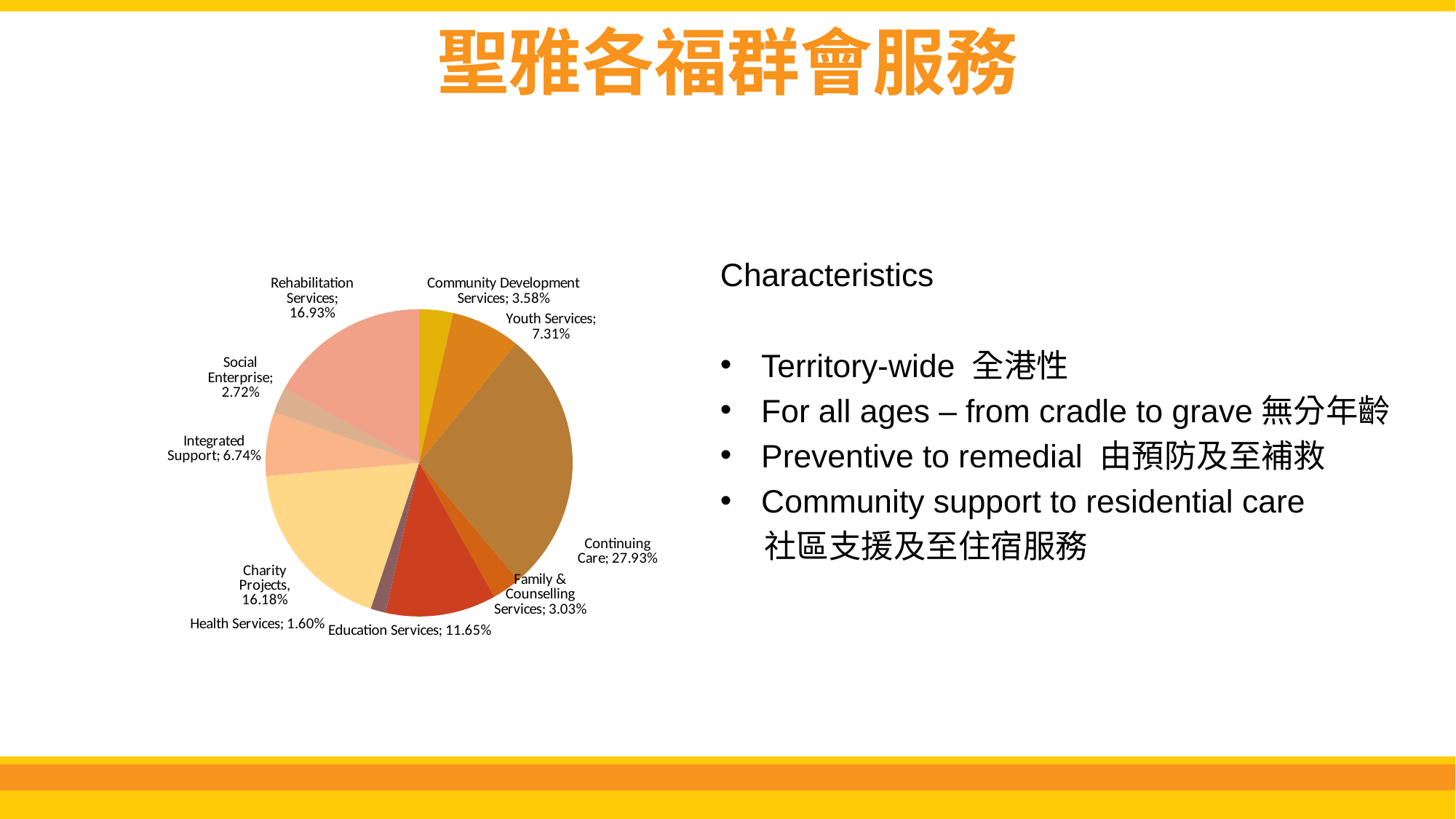
Which category has the largest slice of the pie? Continuing Care What is the difference between Continuing Care and Charity Projects? 11.75% What share of the pie does Continuing Care have? 27.93% How many slices does the pie chart have? 10 Which is larger, Youth Services or Integrated Support? Youth Services What is the difference between Rehabilitation Services and Charity Projects? 0.75% Which category has the smallest slice of the pie? Health Services What is the value shown for Education Services? 11.65% What kind of chart is shown on the slide? pie chart What is the value shown for Social Enterprise? 2.72% What is the value shown for Health Services? 1.60% What is the value shown for Rehabilitation Services? 16.93%